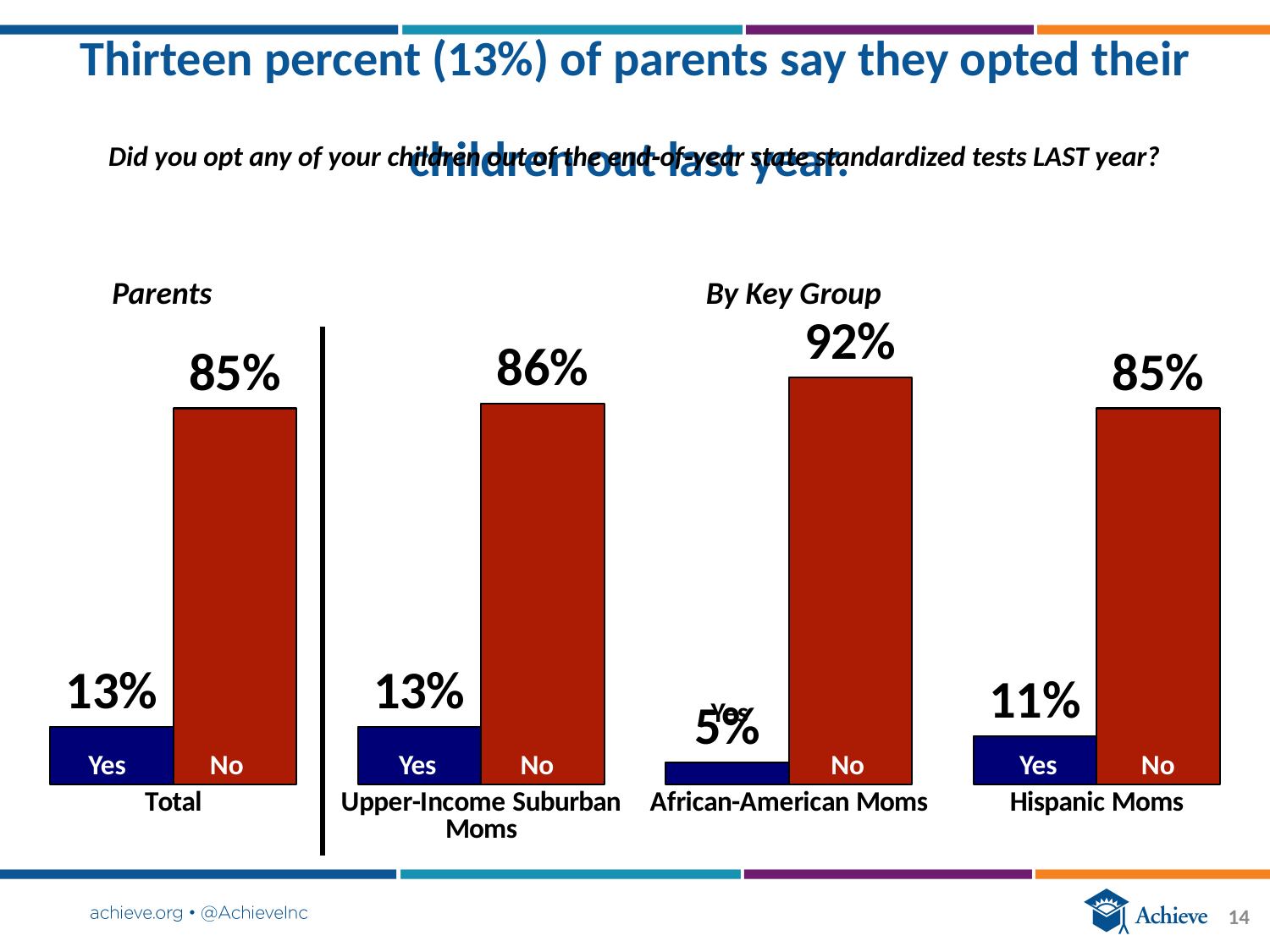
What colour are the "No" bars in the chart? Red Which group has the lowest "Yes" percentage? African-American Moms What kind of chart is shown on the slide? Bar chart What is the "Yes" value for the Total group? 13% What is the difference between the "Yes" values for Total and Hispanic Moms? 2 percentage points Is the "Yes" value larger for Upper-Income Suburban Moms or for African-American Moms? Upper-Income Suburban Moms Which group has the highest "No" percentage? African-American Moms What is the difference between the "No" and "Yes" values for African-American Moms? 87 percentage points What is the "No" value for Upper-Income Suburban Moms? 86% How many groups are shown along the x axis of the chart? 4 What percentage of African-American Moms answered "No"? 92% What percentage of Hispanic Moms answered "Yes"? 11%